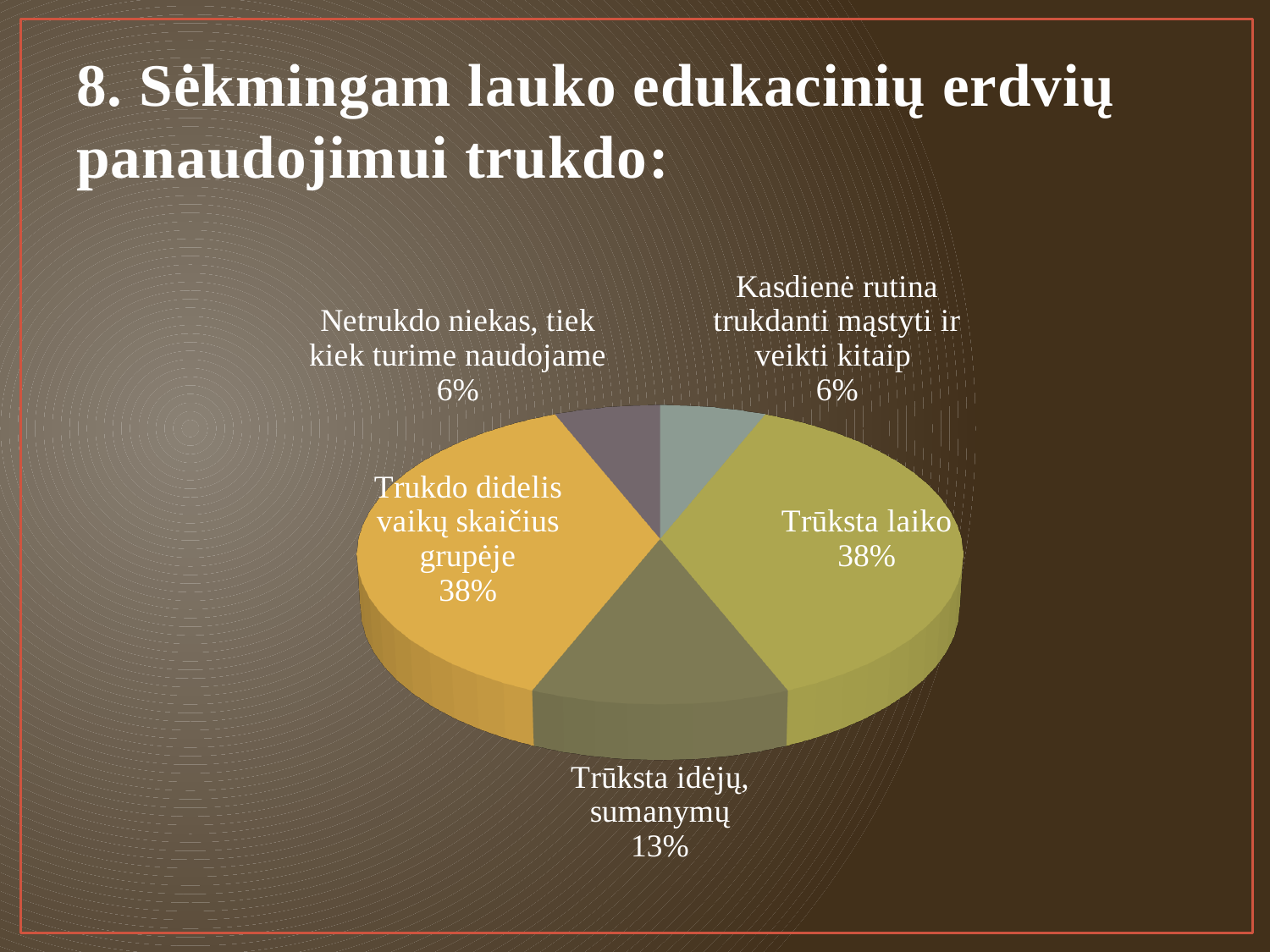
What is the difference in percentage points between "Trūksta laiko" and "Trūksta idėjų, sumanymų"? 25% What kind of chart is shown on the slide? Pie chart What share of the pie does "Trūksta laiko" represent? 38% What percentage is shown for "Kasdienė rutina trukdanti mąstyti ir veikti kitaip"? 6% What share is shown for "Trukdo didelis vaikų skaičius grupėje"? 38% What is the title of the slide containing the pie chart? 8. Sėkmingam lauko edukacinių erdvių panaudojimui trukdo: What percentage is shown for "Trūksta idėjų, sumanymų"? 13% What is the combined share of "Trūksta laiko" and "Trukdo didelis vaikų skaičius grupėje"? 76% How many slices does the pie chart have? 5 What percentage is shown for "Netrukdo niekas, tiek kiek turime naudojame"? 6% Which is larger: the share for "Trūksta laiko" or the share for "Trūksta idėjų, sumanymų"? Trūksta laiko What is the difference in percentage points between "Trukdo didelis vaikų skaičius grupėje" and "Netrukdo niekas, tiek kiek turime naudojame"? 32%